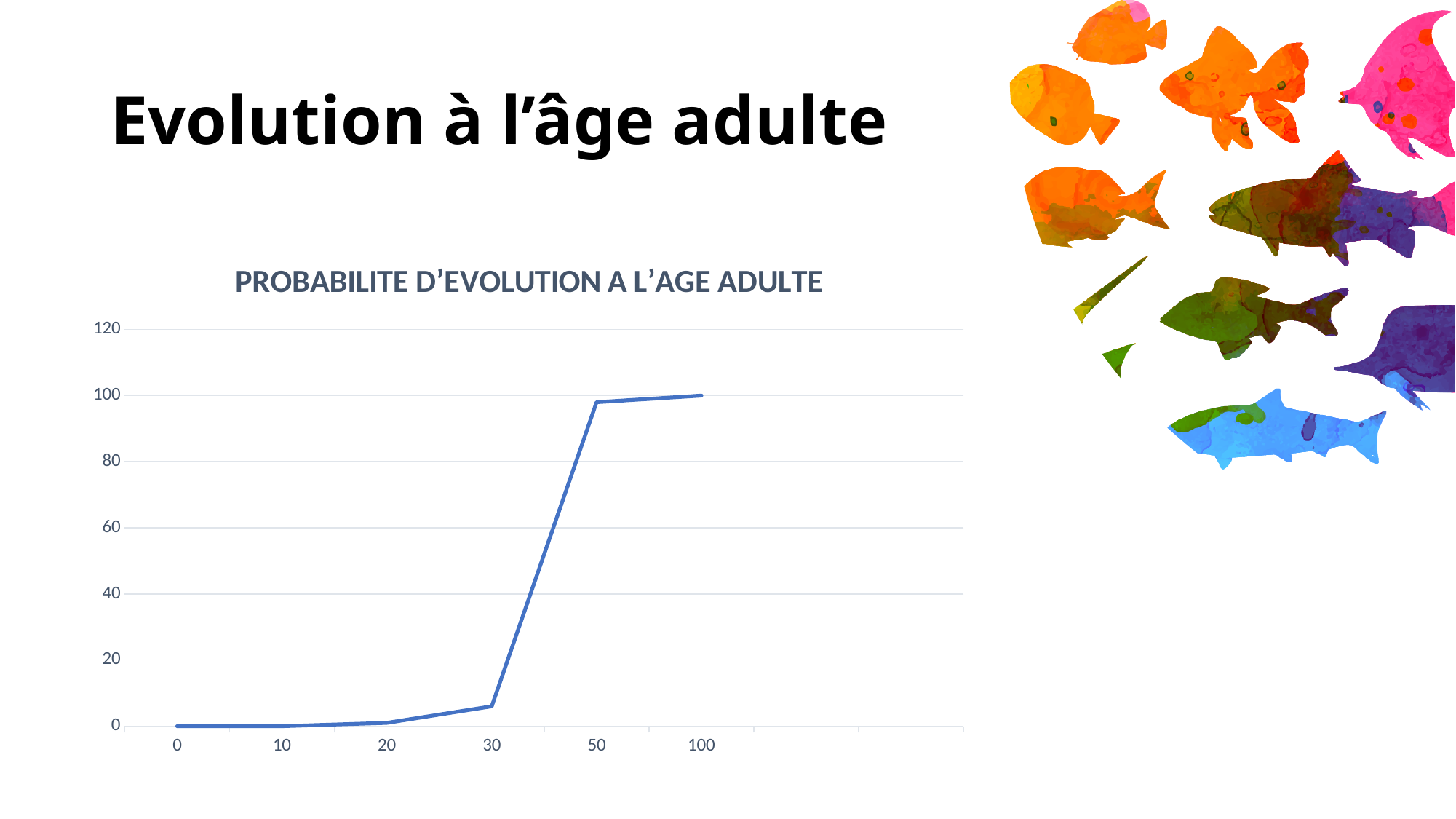
Is the value at x = 50 greater or less than 80? greater What is the title of the chart? PROBABILITE D'EVOLUTION A L'AGE ADULTE What is the value at x = 100? 100 At which x-axis category is the value highest? 100 How many data points are plotted on the line? 6 What is the highest tick value shown on the y axis? 120 Is the value at x = 30 greater or less than 20? less Is the value at x = 20 greater or less than 20? less What kind of chart is shown on the slide? line chart Do the values rise or fall as you move along the x axis from 0 to 100? rise Which is larger, the value at x = 30 or the value at x = 50? x = 50